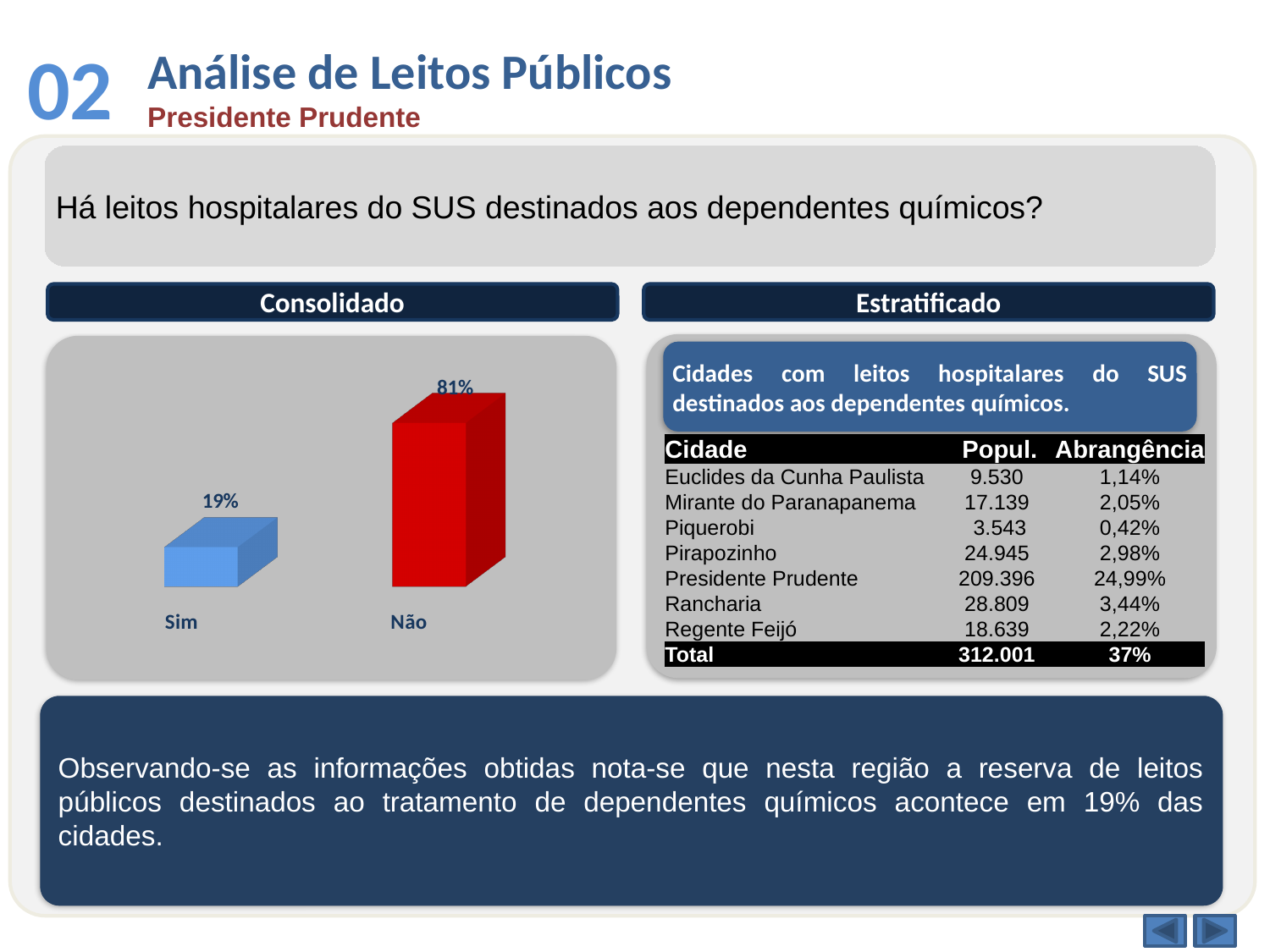
Which category has the highest value in the Consolidado bar chart? Não What kind of chart is shown under the "Consolidado" heading? Bar chart In the Consolidado bar chart, which is larger: the value for "Sim" or the value for "Não"? Não What is the total of the two values shown in the Consolidado bar chart? 100% What colour is the "Não" bar in the Consolidado bar chart? Red How many categories are shown in the Consolidado bar chart? 2 What is the value for "Sim" in the Consolidado bar chart? 19% What colour is the "Sim" bar in the Consolidado bar chart? Blue What is the value for "Não" in the Consolidado bar chart? 81% Which category has the lowest value in the Consolidado bar chart? Sim What is the difference between the values for "Não" and "Sim" in the Consolidado bar chart? 62%